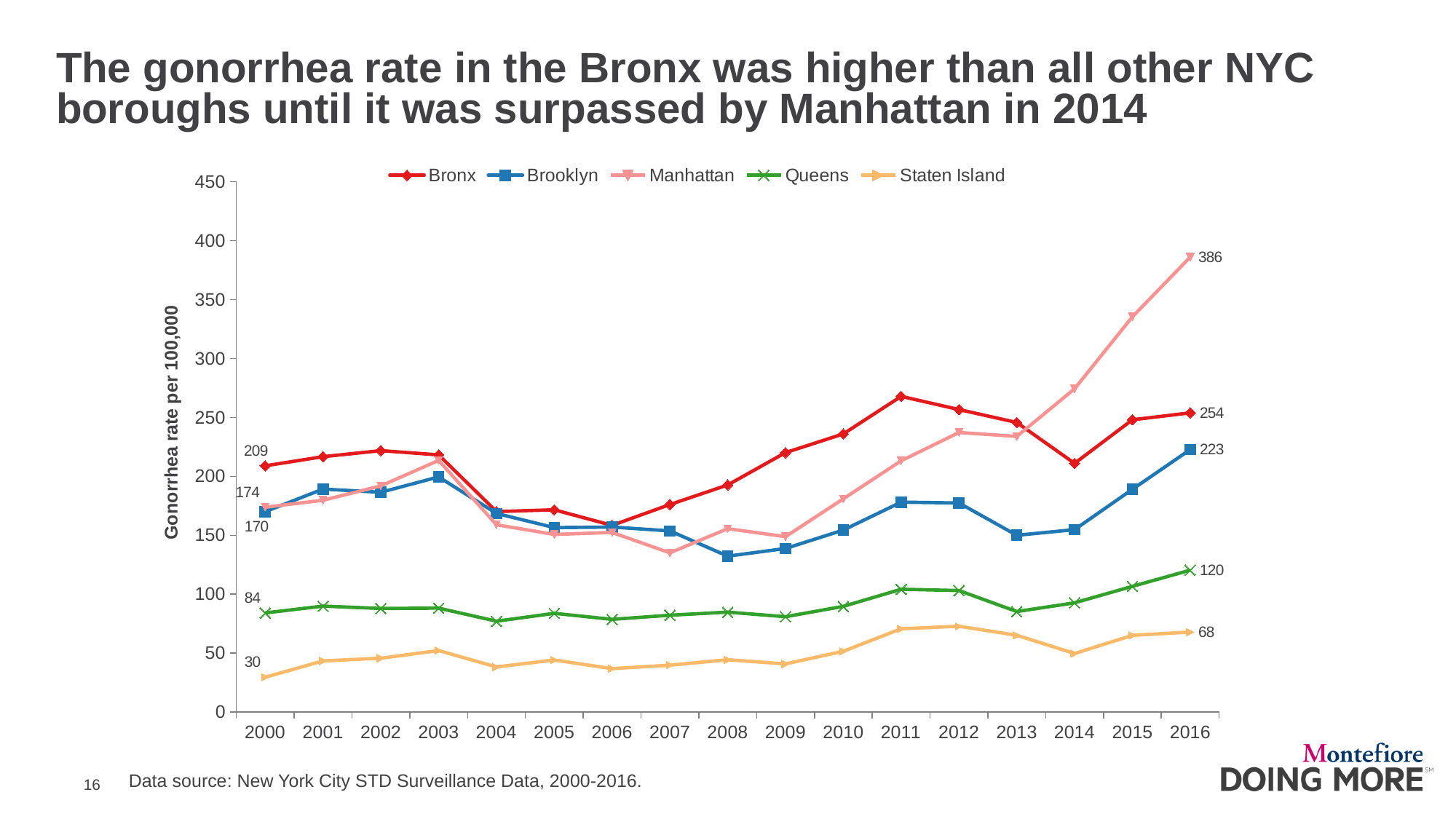
How many series does the legend list? 5 What was the gonorrhea rate per 100,000 in Manhattan in 2016? 386 What was the gonorrhea rate per 100,000 in the Bronx in 2016? 254 Which borough had the lowest gonorrhea rate in 2016? Staten Island What was the gonorrhea rate per 100,000 in Brooklyn in 2016? 223 What was the gonorrhea rate per 100,000 in the Bronx in 2000? 209 How many years are shown on the x axis? 17 What was the gonorrhea rate per 100,000 in Staten Island in 2000? 30 What is the difference between the Manhattan and Bronx gonorrhea rates in 2016? 132 Which borough had the highest gonorrhea rate in 2016? Manhattan Is the Bronx gonorrhea rate in 2011 greater or less than 250? greater What kind of chart is shown on the slide? line chart